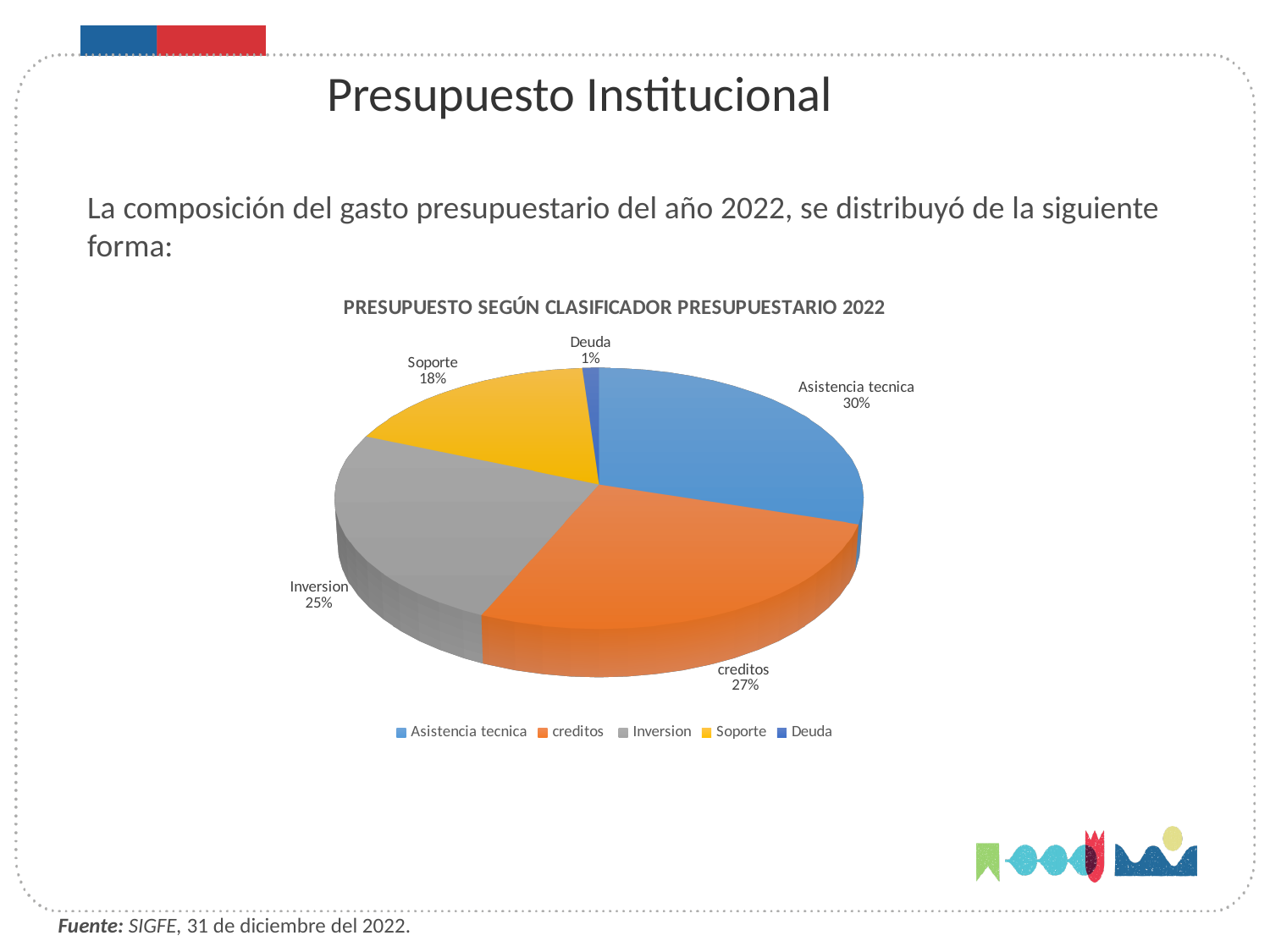
What share of the pie does Asistencia tecnica represent? 30% Which category has the smallest share of the pie? Deuda How many categories does the legend list? 5 What is the difference in percentage points between Asistencia tecnica and Soporte? 12 What share of the pie does Inversion represent? 25% What is the title of the chart? PRESUPUESTO SEGÚN CLASIFICADOR PRESUPUESTARIO 2022 Which category has the largest share of the pie? Asistencia tecnica What kind of chart is shown on the slide? Pie chart What share of the pie does Deuda represent? 1% Which is larger, the share for creditos or the share for Inversion? creditos